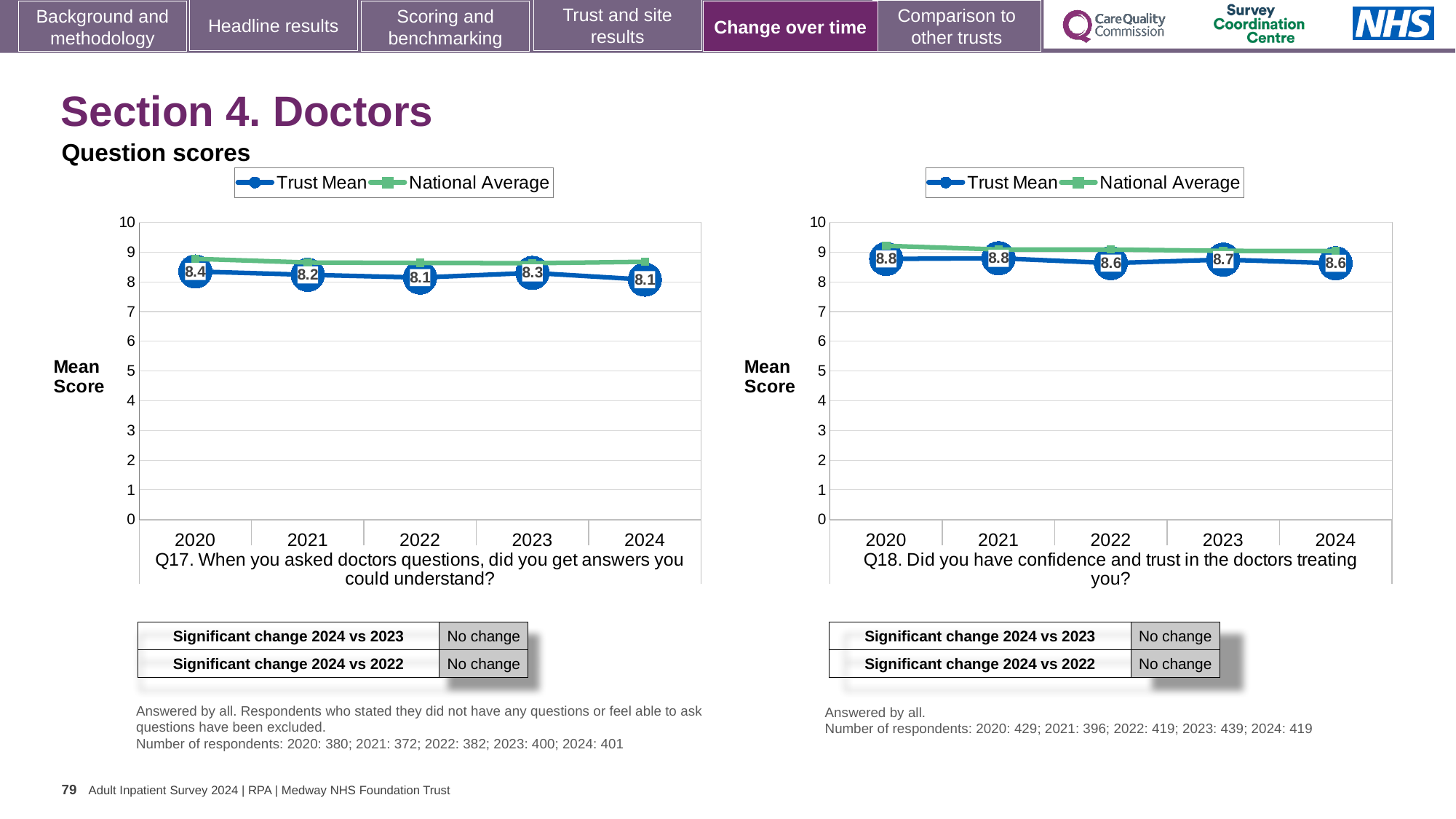
On the Q18 chart, what is the Trust Mean score for 2023? 8.7 On the Q17 chart, what is the Trust Mean score for 2020? 8.4 On the Q18 chart, what is the difference between the Trust Mean scores for 2021 and 2022? 0.2 On the Q17 chart, is the Trust Mean score for 2023 greater or less than the Trust Mean score for 2022? greater How many series does the legend of the Q17 chart list? 2 What type of chart is used for Q17? Line chart On the Q17 chart, which year has the highest Trust Mean score? 2020 On the Q18 chart, is the National Average value for 2020 greater or less than 8? greater On the Q17 chart, what is the Trust Mean score for 2024? 8.1 How many years are plotted on the Q18 chart? 5 On the Q17 chart, what is the difference between the Trust Mean scores for 2020 and 2024? 0.3 On the Q18 chart, what is the Trust Mean score for 2022? 8.6